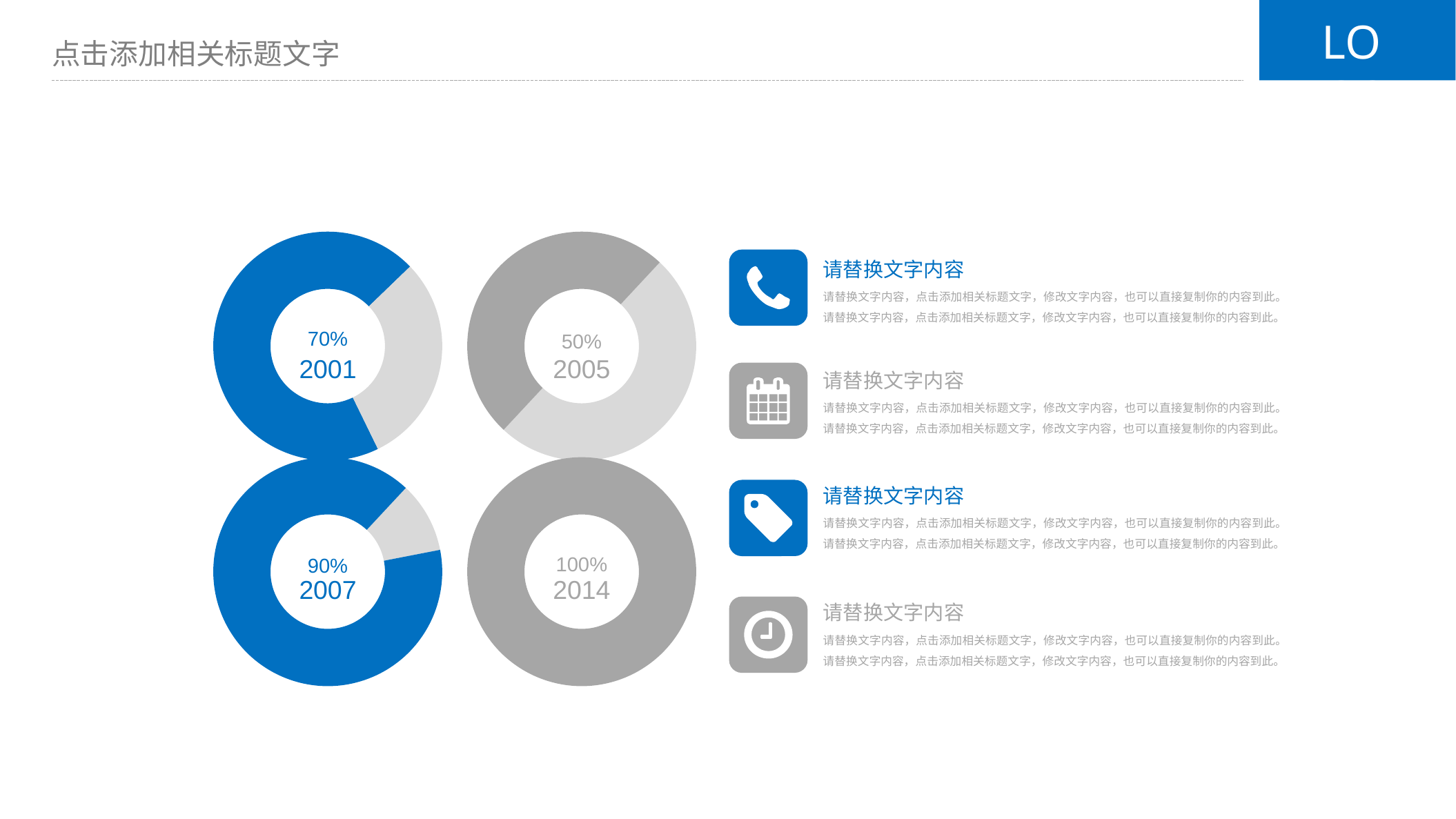
What colour is the filled portion of the donut chart labelled 2007? Blue What kind of chart is used to show the percentages for 2001, 2005, 2007 and 2014? Donut chart What percentage is shown in the centre of the donut chart labelled 2007? 90% Which year's donut chart shows the highest percentage? 2014 Which shows a larger percentage, the 2001 donut chart or the 2005 donut chart? 2001 How many donut charts are shown on the slide? 4 Which year's donut chart shows the lowest percentage? 2005 What percentage is shown in the centre of the donut chart labelled 2014? 100% What is the difference between the percentage shown for 2014 and the percentage shown for 2005? 50% What percentage is shown in the centre of the donut chart labelled 2005? 50% What percentage is shown in the centre of the donut chart labelled 2001? 70% What is the difference between the percentage shown for 2007 and the percentage shown for 2001? 20%